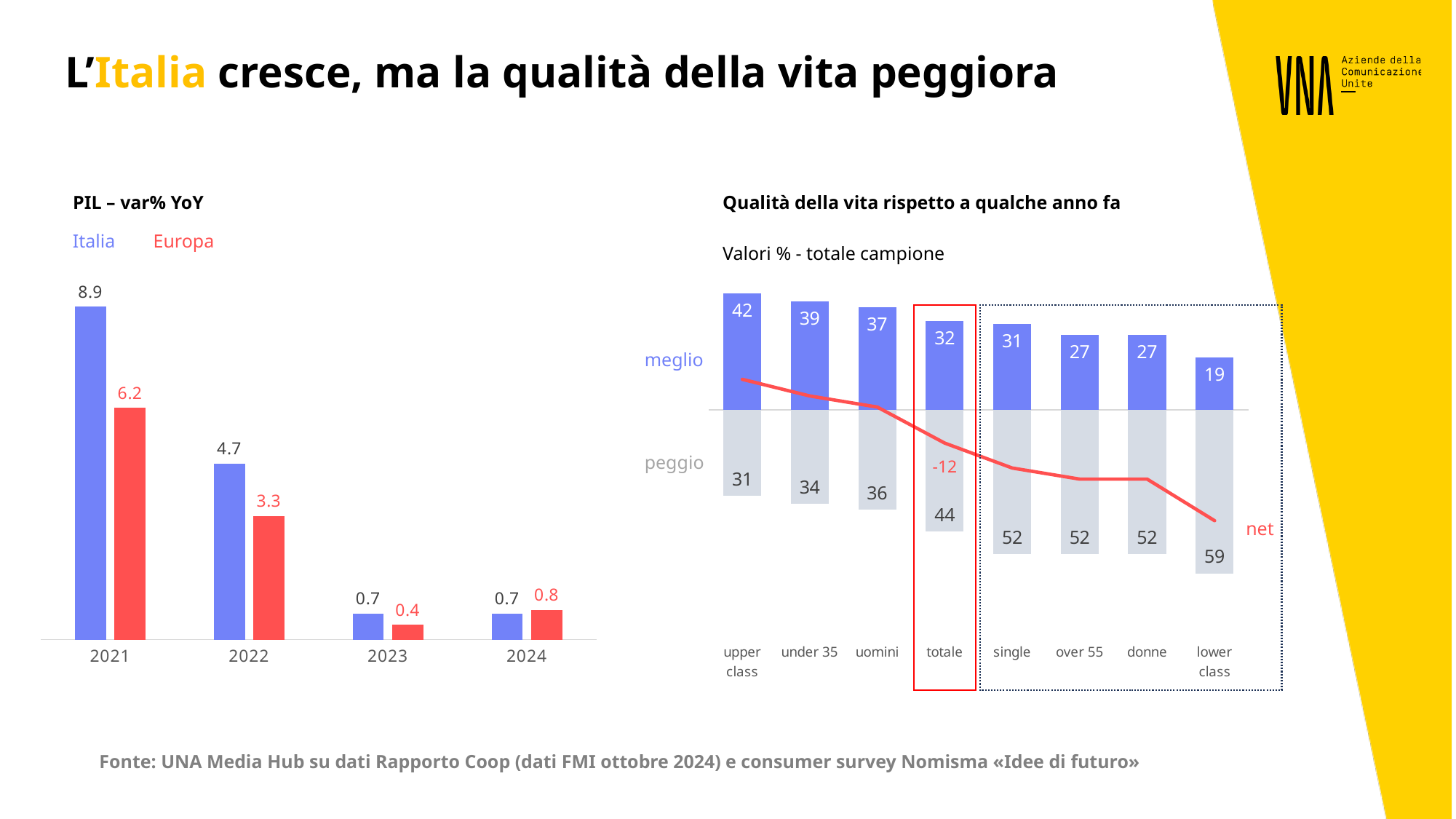
In the 'Qualità della vita rispetto a qualche anno fa' chart, how many categories are shown on the x axis? 8 In the 'PIL – var% YoY' chart, what is the value for Europa in 2022? 3.3 In the 'Qualità della vita rispetto a qualche anno fa' chart, what is the 'meglio' value for totale? 32 In the 'Qualità della vita rispetto a qualche anno fa' chart, what is the 'peggio' value for lower class? 59 In the 'PIL – var% YoY' chart, do the Italia values rise or fall from 2021 to 2023? fall In the 'PIL – var% YoY' chart, which is larger in 2024, Italia or Europa? Europa In the 'PIL – var% YoY' chart, how many series does the legend list? 2 In the 'PIL – var% YoY' chart, what is the value for Italia in 2021? 8.9 In the 'PIL – var% YoY' chart, what is the difference between the Italia and Europa values in 2021? 2.7 In the 'PIL – var% YoY' chart, which year has the highest value for Italia? 2021 In the 'Qualità della vita rispetto a qualche anno fa' chart, which category has the highest 'meglio' value? upper class What kind of chart is the 'PIL – var% YoY' chart? bar chart